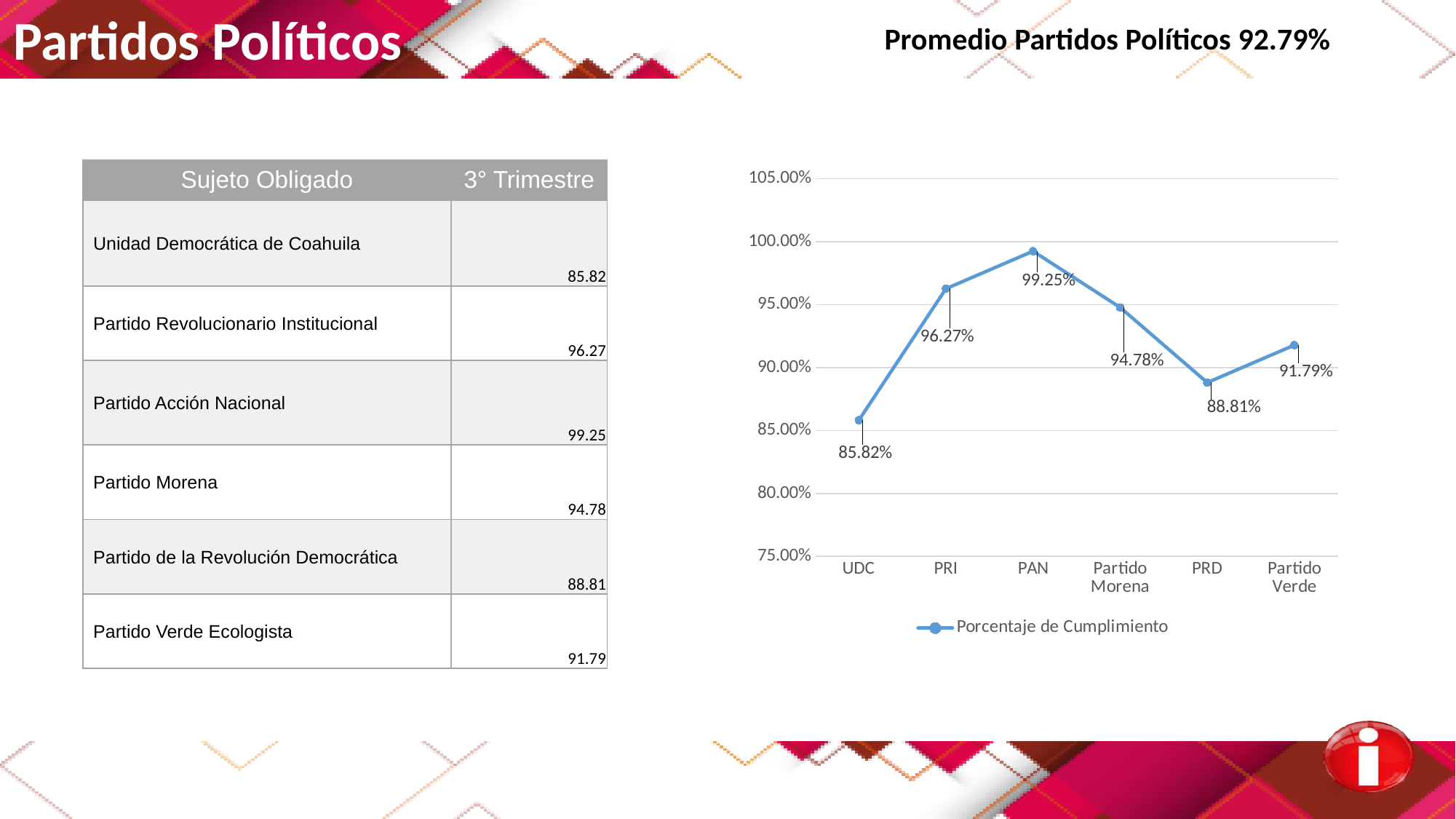
How many series does the chart legend list? 1 Which category has the highest value in the chart? PAN What is the value for PRD in the chart? 88.81% What kind of chart is shown on the slide? line chart What is the value for PAN in the chart? 99.25% What is the value for Partido Verde in the chart? 91.79% Which is larger, the value for PRI or the value for Partido Morena? PRI Is the value for PRD greater or less than 90.00%? less What is the difference between the values for PAN and UDC? 13.43% How many categories are plotted on the x axis of the chart? 6 What is the name of the series shown in the chart legend? Porcentaje de Cumplimiento Which category has the lowest value in the chart? UDC